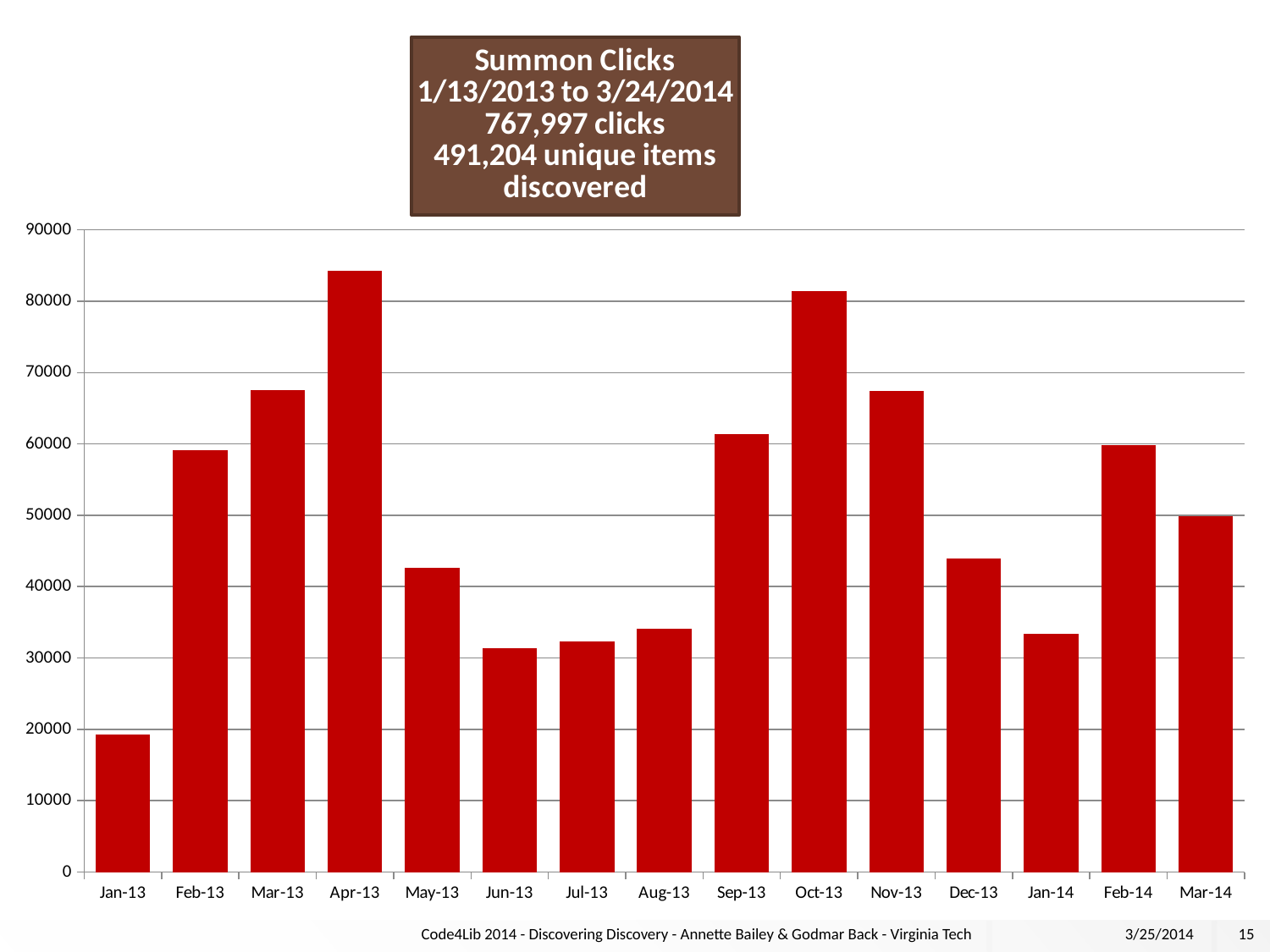
What kind of chart is shown on the slide? bar chart Is the value for Apr-13 greater or less than 80000? greater Do the values rise or fall from Apr-13 to Jun-13? fall Which month has the lowest number of Summon clicks? Jan-13 Which month has the highest number of Summon clicks? Apr-13 How many months are plotted on the x axis? 15 Which is larger, the value for Oct-13 or the value for Sep-13? Oct-13 According to the title box, how many total clicks were recorded from 1/13/2013 to 3/24/2014? 767,997 clicks Is the value for Jan-13 greater or less than 20000? less Is the value for Nov-13 greater or less than 70000? less Which is larger, the value for Jan-14 or the value for Jan-13? Jan-14